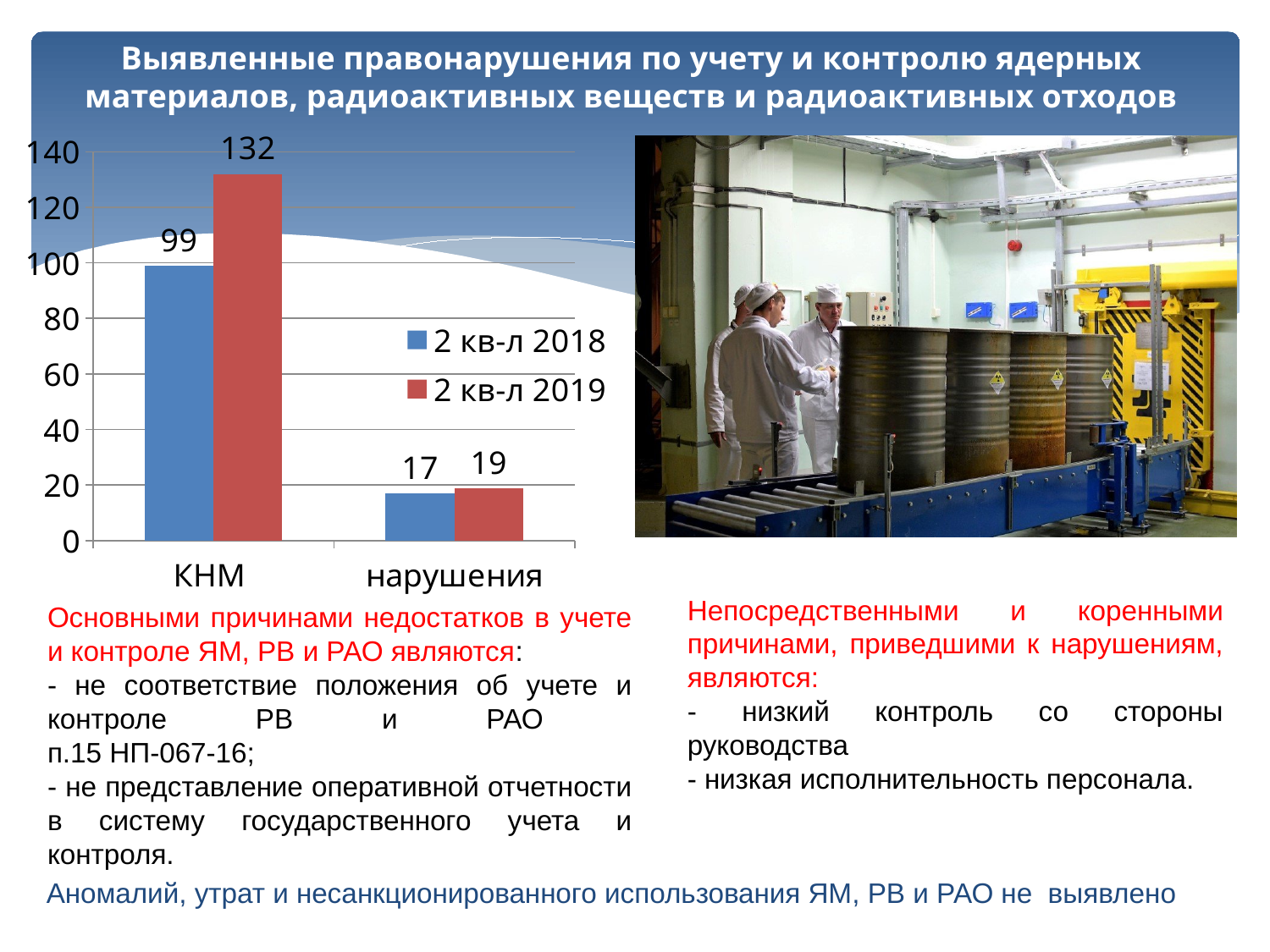
What is the difference between the 2 кв-л 2019 and 2 кв-л 2018 values for КНМ? 33 What is the value for нарушения in the 2 кв-л 2019 series? 19 Which category has the highest value in the 2 кв-л 2019 series? КНМ How many categories are shown on the x axis of the chart? 2 What is the value for КНМ in the 2 кв-л 2019 series? 132 Which category has the lowest value in the 2 кв-л 2018 series? нарушения Which is larger for КНМ: the 2 кв-л 2018 value or the 2 кв-л 2019 value? 2 кв-л 2019 What is the difference between the 2 кв-л 2019 and 2 кв-л 2018 values for нарушения? 2 What is the value for нарушения in the 2 кв-л 2018 series? 17 What is the value for КНМ in the 2 кв-л 2018 series? 99 What kind of chart is shown on the slide? bar chart How many series does the chart legend list? 2